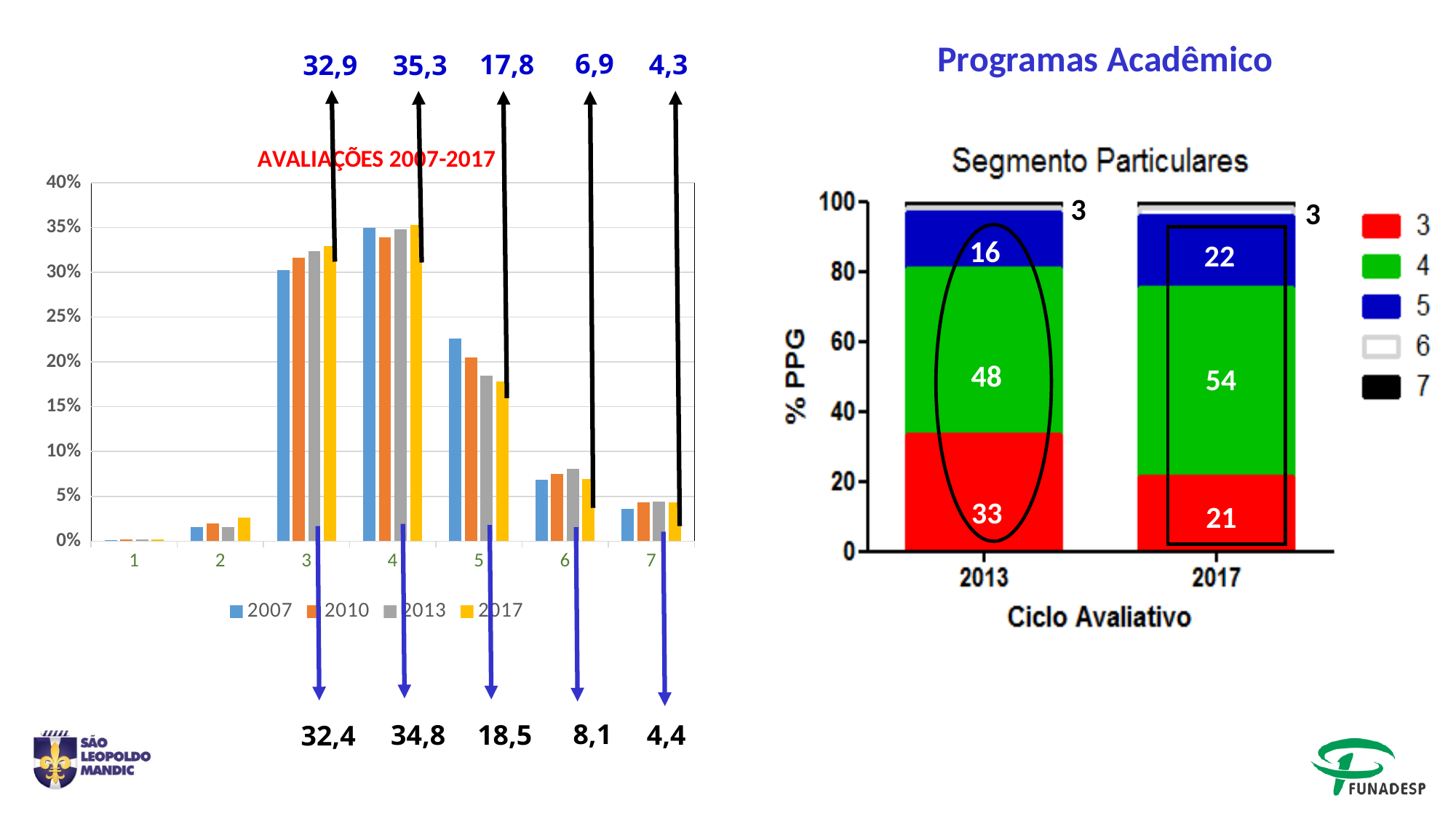
In the 'AVALIAÇÕES 2007-2017' chart, which category has the highest 2017 value? 4 In the 'AVALIAÇÕES 2007-2017' chart, is the 2007 value for category 5 greater or less than 20%? greater How many categories are shown on the x axis of the 'AVALIAÇÕES 2007-2017' chart? 7 How many series does the legend of the 'AVALIAÇÕES 2007-2017' chart on the left list? 4 What kind of chart is the 'Segmento Particulares' chart on the right? stacked bar chart In the 'Segmento Particulares' chart, what is the value of segment 4 for 2017? 54 In the 'AVALIAÇÕES 2007-2017' chart, what is the 2013 value for category 5? 18,5 In the 'Segmento Particulares' chart, what is the value of segment 3 for 2013? 33 In the 'Segmento Particulares' chart, by how much does segment 4 differ between 2013 and 2017? 6 How many entries does the legend of the 'Segmento Particulares' chart list? 5 In the 'AVALIAÇÕES 2007-2017' chart, what is the 2017 value for category 4? 35,3 In the 'Segmento Particulares' chart, which year has the larger value for segment 3, 2013 or 2017? 2013